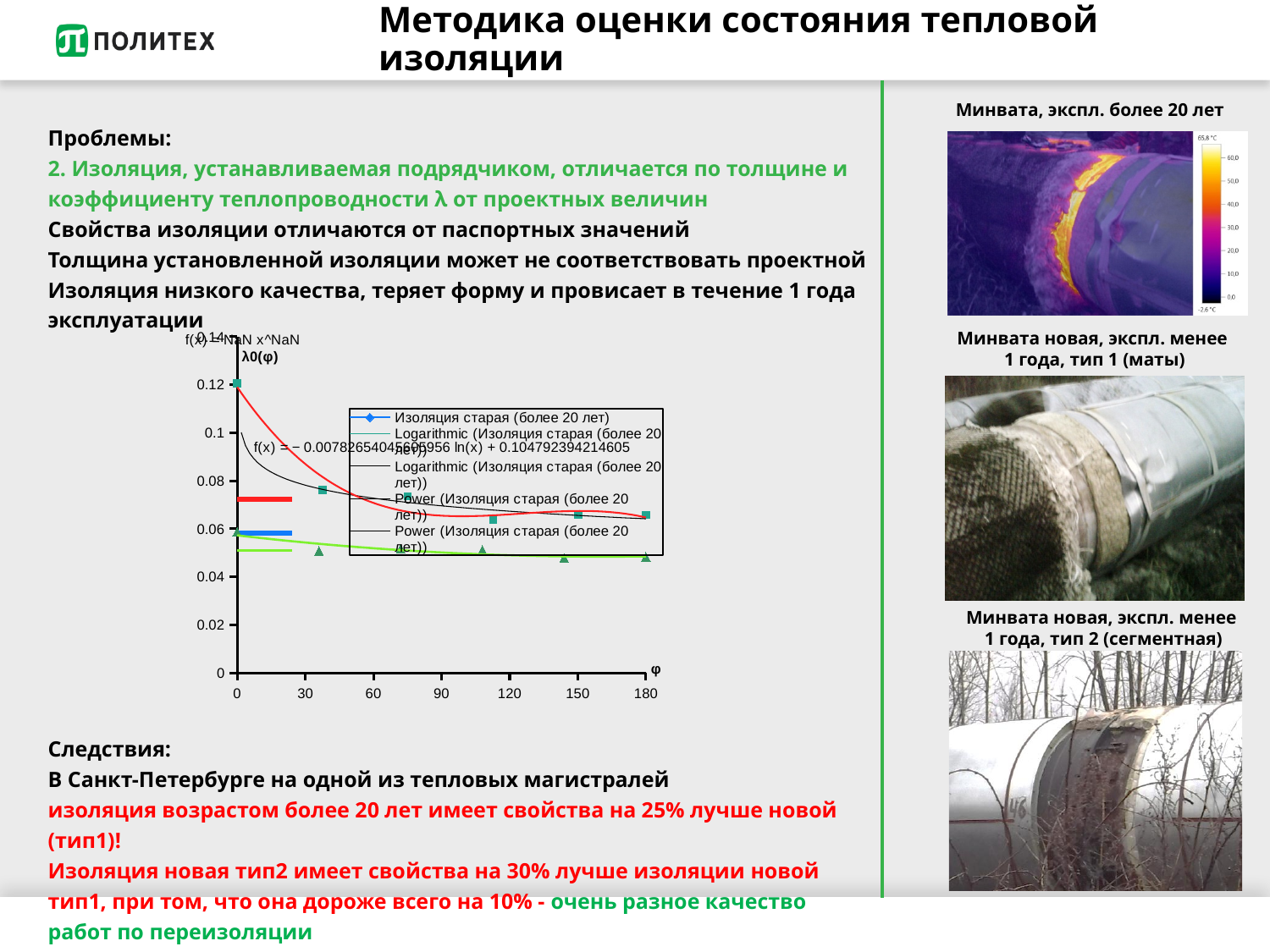
Is the value of the triangle-marker point near φ = 30 greater or less than 0.06? less Is the value of the square-marker point at φ = 180 greater or less than 0.08? less What kind of chart is shown on the slide? scatter chart What is the label of the vertical axis of the chart? λ0(φ) What is the label of the horizontal axis of the chart? φ What is the highest tick value shown on the vertical axis of the chart? 0.14 How many entries does the chart legend list? 5 Is the value of the square-marker point at φ = 0 greater or less than 0.1? greater Do the square-marker values rise or fall as φ increases from 0 to 180? fall What is the highest tick value shown on the horizontal axis of the chart? 180 At φ = 180, which series has the higher value, the square markers or the triangle markers? square markers